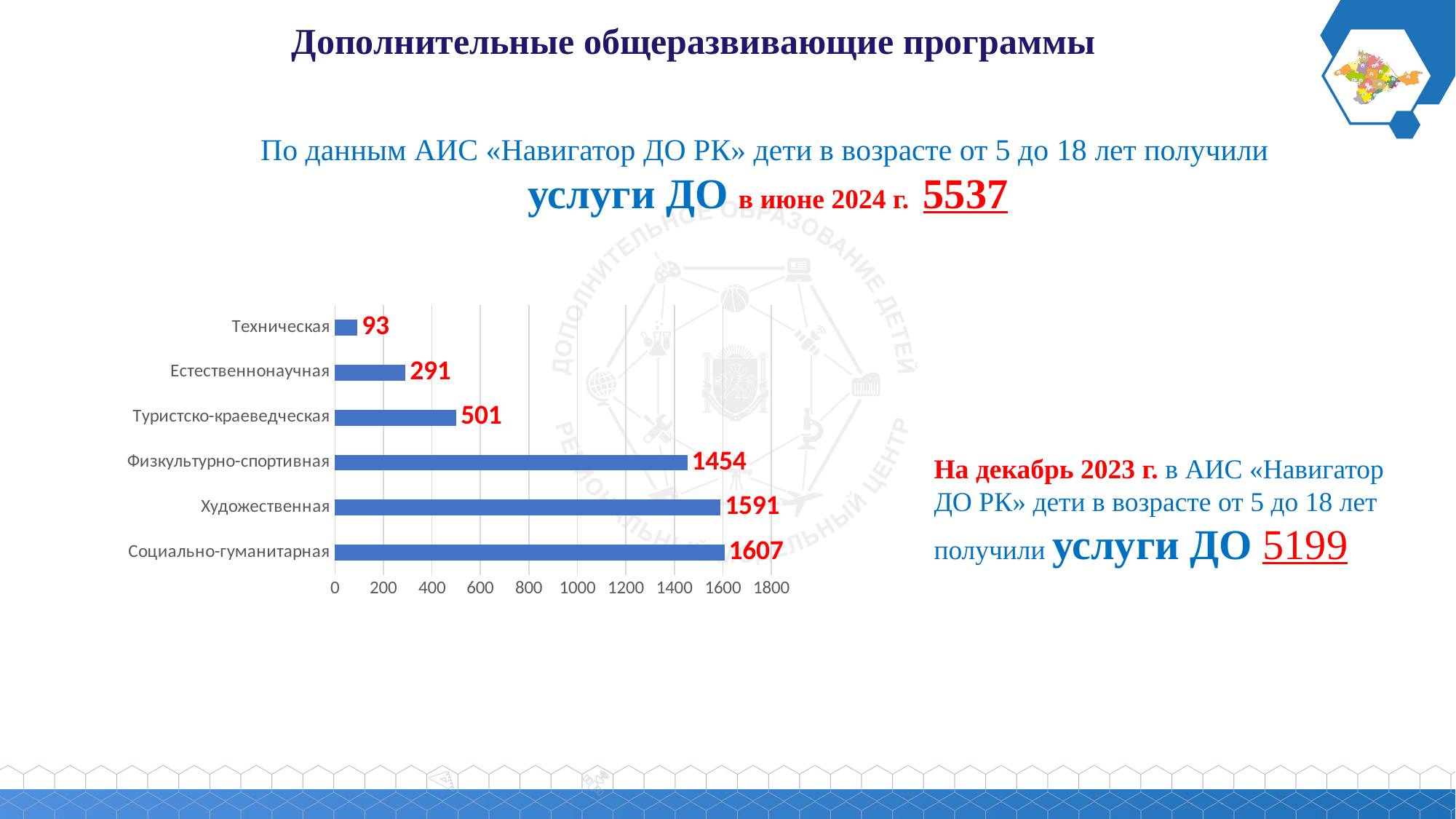
How many categories are shown in the chart? 6 What is the difference between Естественнонаучная and Техническая? 198 What is the difference between Художественная and Физкультурно-спортивная? 137 What kind of chart is shown on the slide? bar chart Is the value for Физкультурно-спортивная greater or less than 1400? greater What is the value for Техническая? 93 Which category has the highest value? Социально-гуманитарная Which category has the lowest value? Техническая What is the value for Социально-гуманитарная? 1607 What is the value for Физкультурно-спортивная? 1454 What is the value for Туристско-краеведческая? 501 Which is larger, Естественнонаучная or Туристско-краеведческая? Туристско-краеведческая